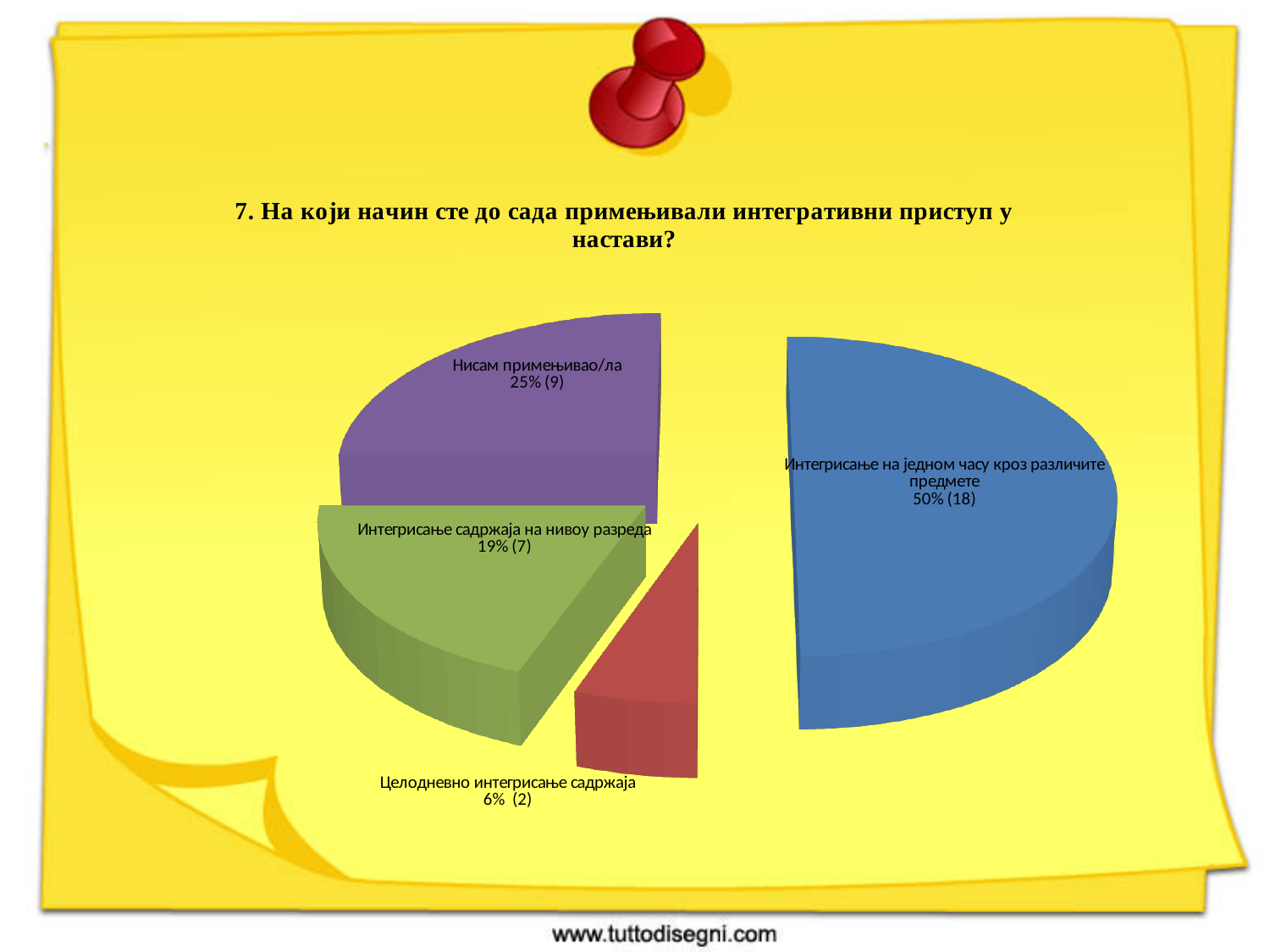
How many more respondents chose "Интегрисање на једном часу кроз различите предмете" than "Нисам примењивао/ла"? 9 What share of the pie does "Нисам примењивао/ла" represent? 25% Which is larger: "Интегрисање садржаја на нивоу разреда" or "Целодневно интегрисање садржаја"? Интегрисање садржаја на нивоу разреда What is the value shown for "Интегрисање садржаја на нивоу разреда"? 19% (7) Which category has the largest share of the pie? Интегрисање на једном часу кроз различите предмете What is the value shown for "Интегрисање на једном часу кроз различите предмете"? 50% (18) What is the value shown for "Целодневно интегрисање садржаја"? 6% (2) What colour is the slice for "Интегрисање на једном часу кроз различите предмете"? blue Which category has the smallest share of the pie? Целодневно интегрисање садржаја What is the value shown for "Нисам примењивао/ла"? 25% (9) What kind of chart is shown on the slide? pie chart How many slices does the pie chart have? 4